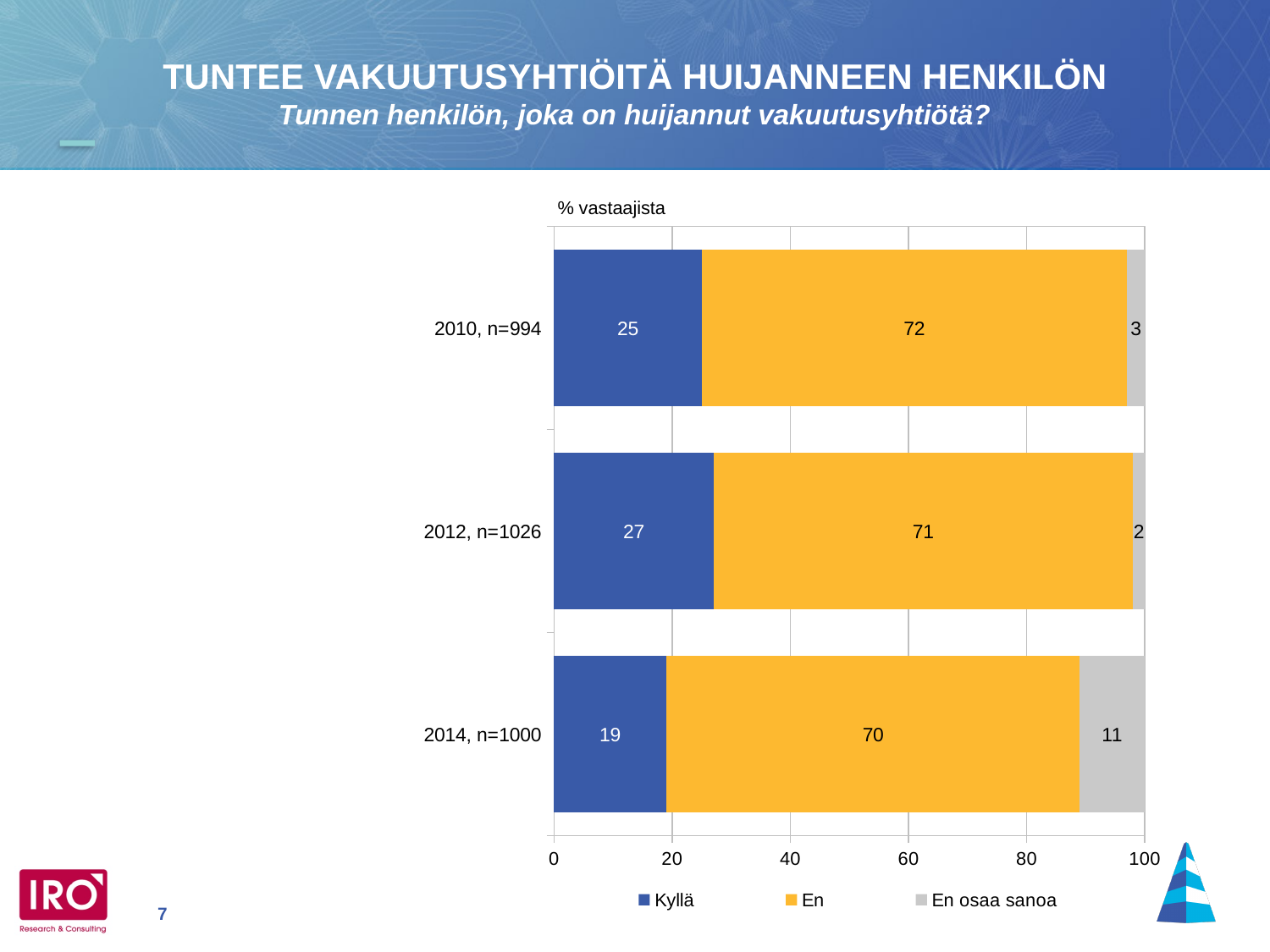
What is the difference between the Kyllä values for 2012, n=1026 and 2014, n=1000? 8 How many series does the legend list? 3 What is the value for En osaa sanoa in 2012, n=1026? 2 Which is larger: the En value for 2010, n=994 or for 2014, n=1000? 2010, n=994 What is the axis label shown above the chart? % vastaajista What kind of chart is shown on the slide? Stacked bar chart What is the value for En in 2014, n=1000? 70 Which category has the highest value for Kyllä? 2012, n=1026 How many categories are shown on the chart? 3 Which category has the lowest value for En osaa sanoa? 2012, n=1026 What is the total of the stacked bar for 2014, n=1000? 100 What is the value for Kyllä in 2010, n=994? 25